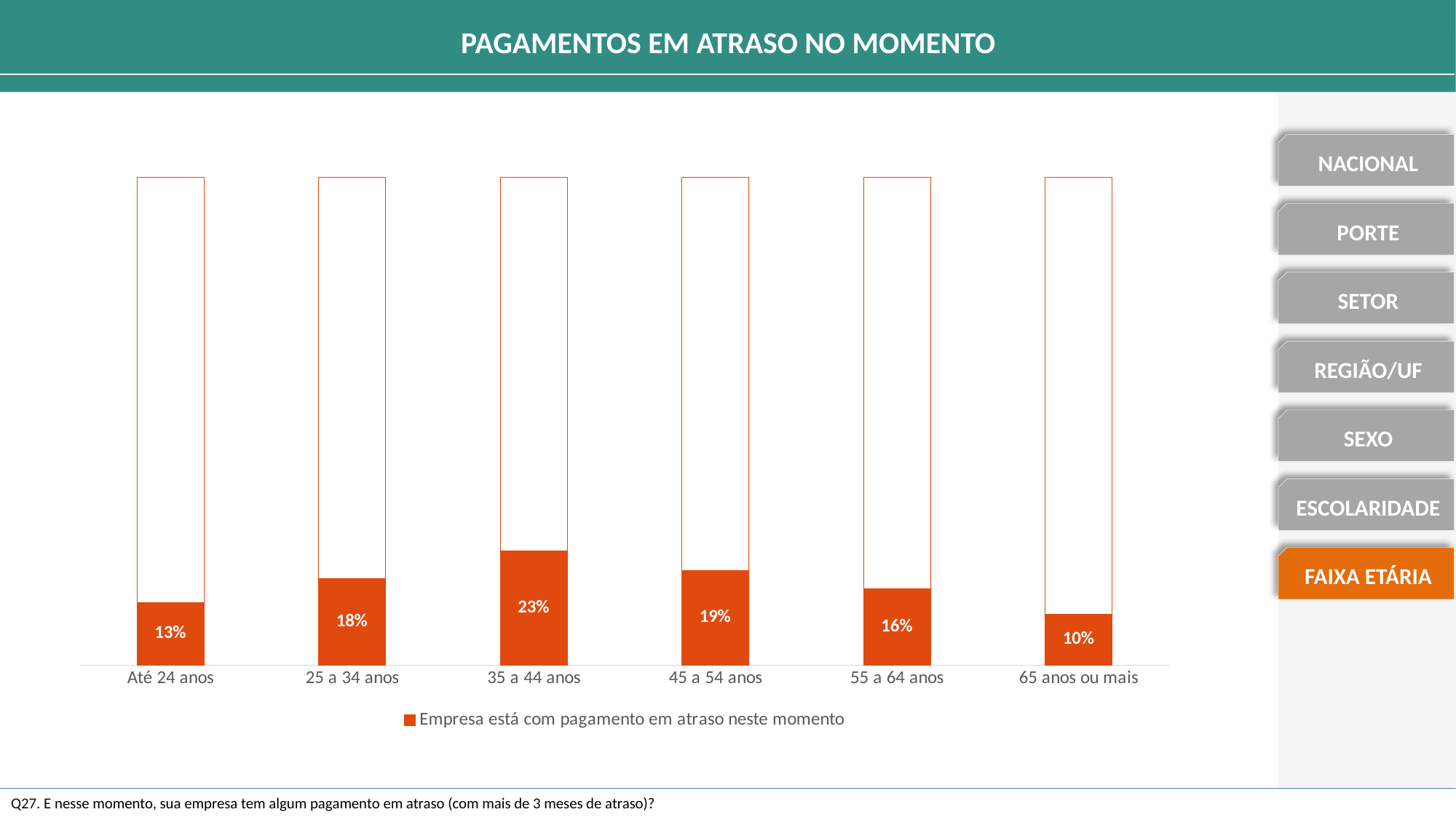
What is the difference between the values for '35 a 44 anos' and '65 anos ou mais'? 13% How many series does the legend list? 1 What is the title of the slide? PAGAMENTOS EM ATRASO NO MOMENTO Which age group has the highest value? 35 a 44 anos What is the value for 'Até 24 anos'? 13% Which is larger, the value for '25 a 34 anos' or the value for '45 a 54 anos'? 45 a 54 anos What kind of chart is shown on the slide? Bar chart What is the value for '35 a 44 anos'? 23% How many age groups are shown on the x axis? 6 What is the value for '65 anos ou mais'? 10% Which age group has the lowest value? 65 anos ou mais What is the value for '55 a 64 anos'? 16%